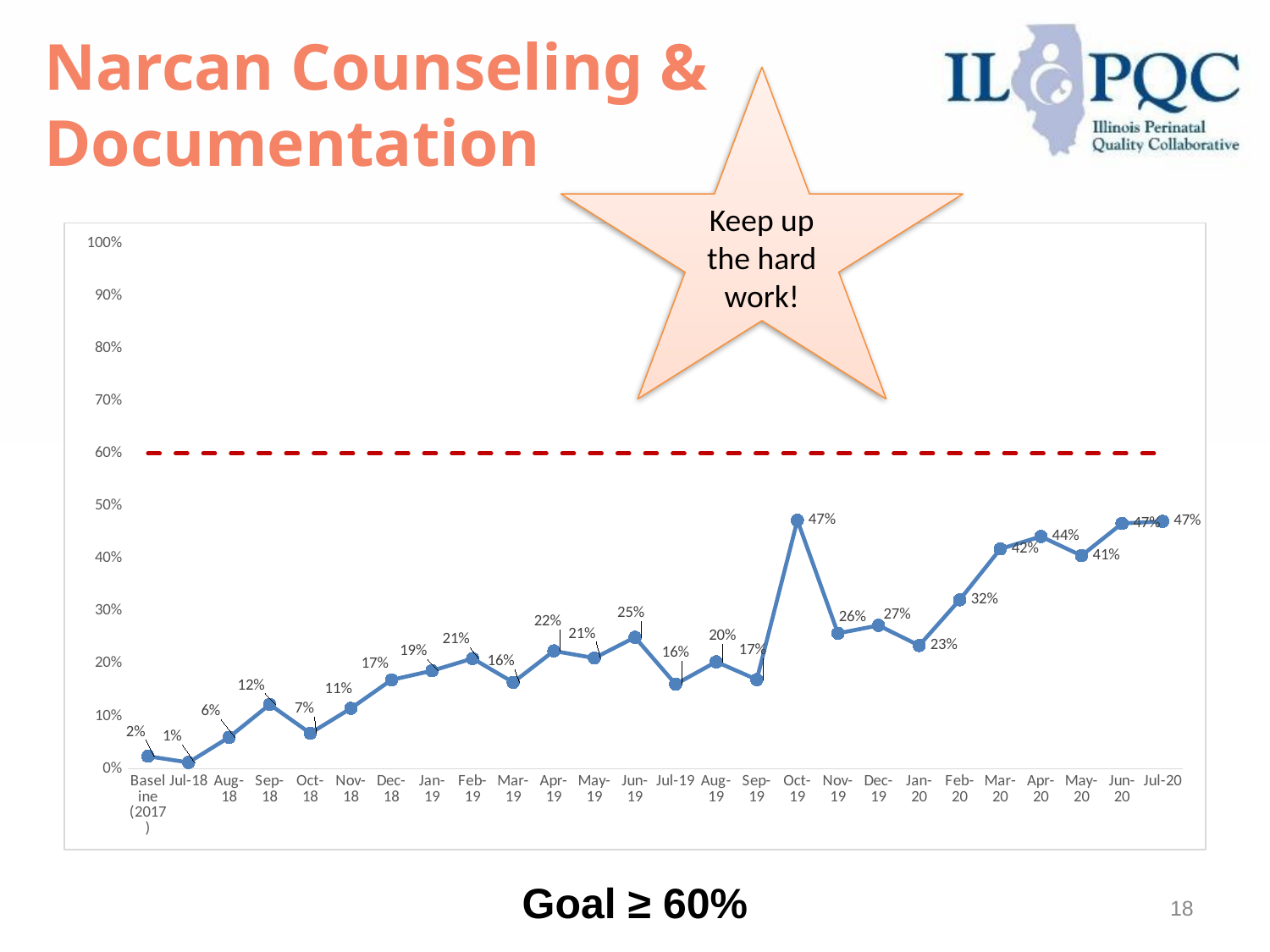
What is the value for the Baseline (2017) point? 2% What kind of chart is shown on the slide? line chart Which is larger, the value for Oct-19 or the value for Nov-19? Oct-19 What is the value for Sep-18? 12% How many data points are plotted on the chart? 26 What is the highest value reached on the chart? 47% What is the difference between the Jul-20 value and the Baseline (2017) value? 45% At what percentage is the dashed red goal line drawn? 60% Is the value for Jul-20 greater or less than 60%? less Which month has the lowest value on the chart? Jul-18 What is the value for Jun-19? 25% What is the value for Oct-19? 47%